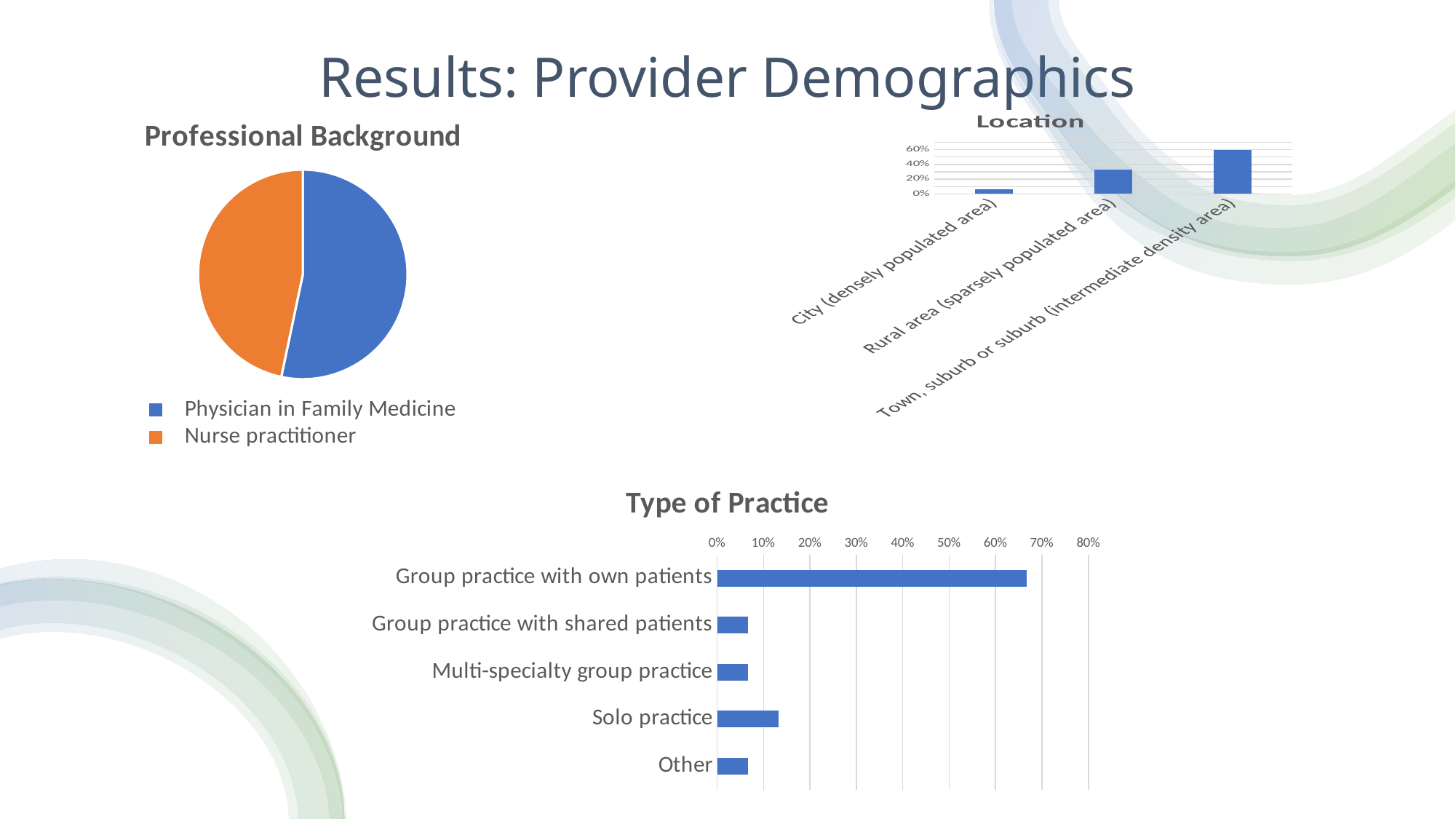
In the Type of Practice chart, is the value for Group practice with own patients greater or less than 60%? greater In the Location chart, is the value for City (densely populated area) greater or less than 20%? less What kind of chart is the Location chart? bar chart How many categories does the legend of the Professional Background chart list? 2 In the Location chart, which category has the highest value? Town, suburb or suburb (intermediate density area) How many categories are shown in the Type of Practice chart? 5 What kind of chart is the Professional Background chart? pie chart In the Type of Practice chart, which category has the highest value? Group practice with own patients In the Location chart, is the value for Town, suburb or suburb (intermediate density area) greater or less than 40%? greater In the Type of Practice chart, which is larger, Solo practice or Other? Solo practice In the Location chart, which category has the lowest value? City (densely populated area) In the Professional Background chart, which category is shown in orange? Nurse practitioner